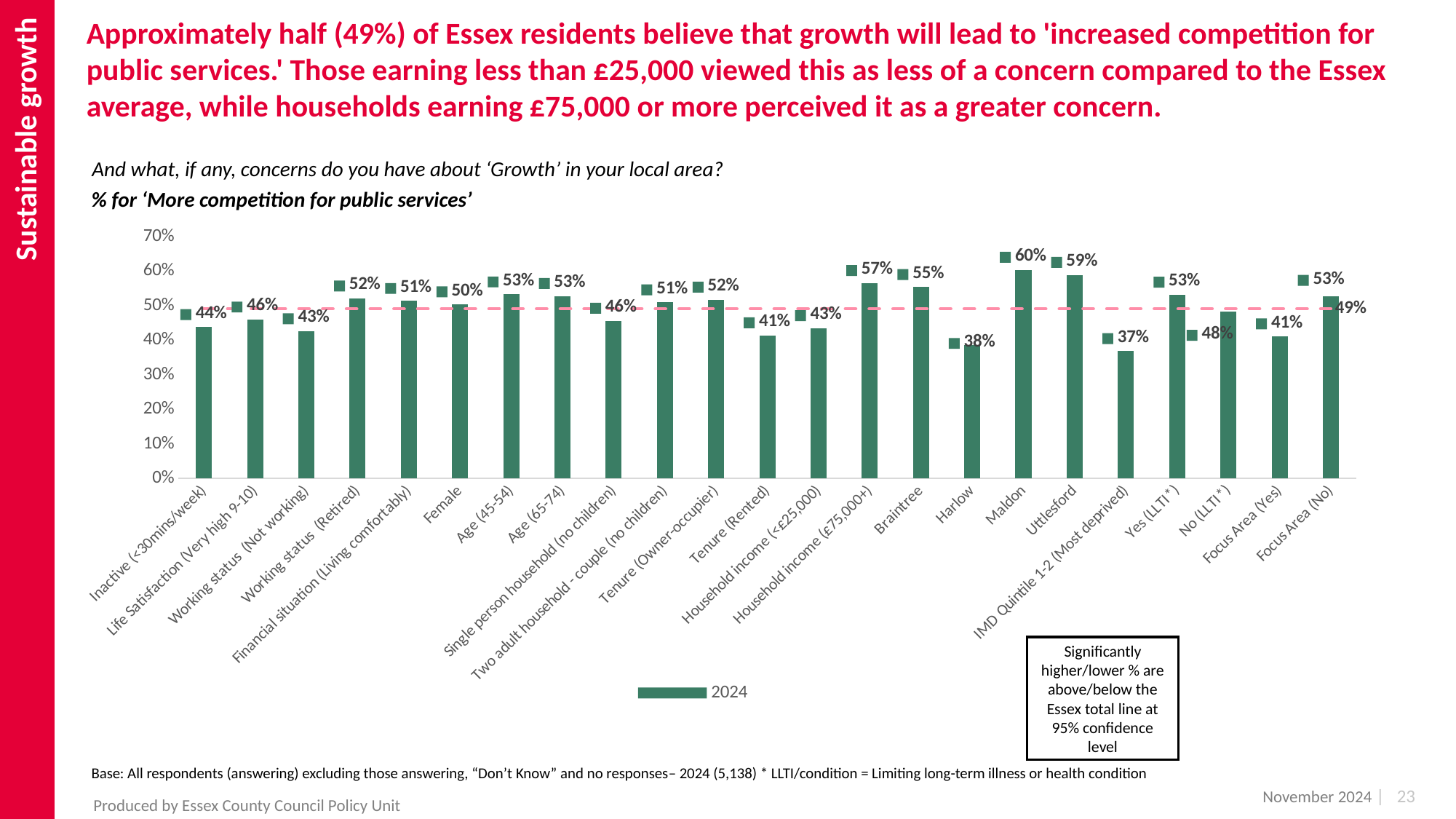
How many categories are shown on the x axis? 23 Which category has the highest value? Maldon Which is larger, the value for Braintree or the value for Harlow? Braintree What is the value for Household income (<£25,000)? 43% How many series does the legend list? 1 What is the value for Harlow? 38% What is the value for Maldon? 60% What kind of chart is this? Bar chart What is the value for Tenure (Rented)? 41% What is the difference between Household income (£75,000+) and Household income (<£25,000)? 14 percentage points What year does the legend entry show? 2024 Which category has the lowest value? IMD Quintile 1-2 (Most deprived)